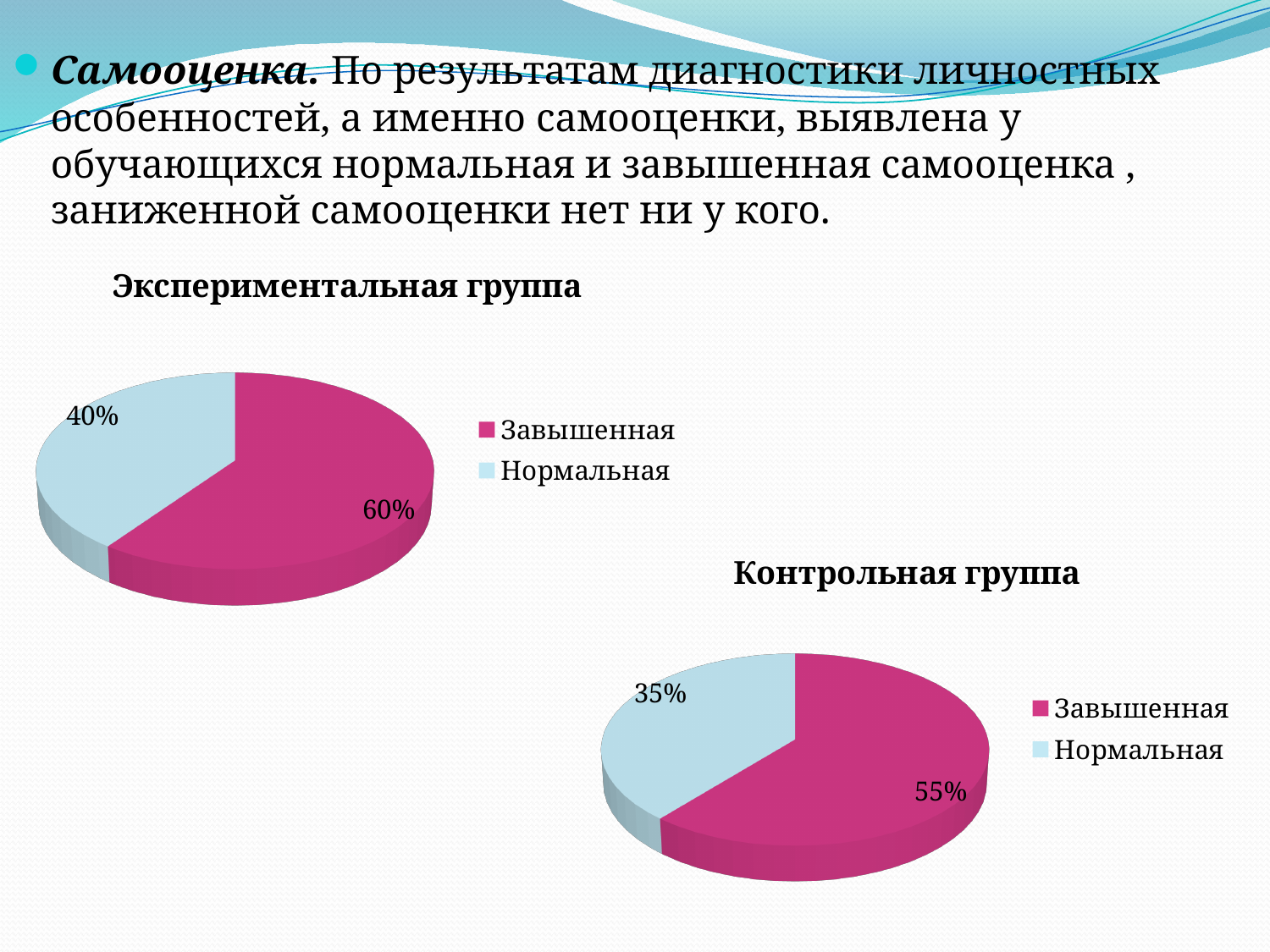
How many categories does the legend of the 'Экспериментальная группа' chart list? 2 In the 'Экспериментальная группа' chart, what is the difference between Завышенная and Нормальная? 20% In the 'Контрольная группа' chart, what is the difference between Завышенная and Нормальная? 20% Which is larger: Завышенная in the 'Экспериментальная группа' chart or Завышенная in the 'Контрольная группа' chart? Экспериментальная группа In the 'Экспериментальная группа' chart, what is the value for Завышенная? 60% In the 'Контрольная группа' chart, what is the value for Нормальная? 35% In the 'Экспериментальная группа' chart, what is the value for Нормальная? 40% What type of chart is the 'Контрольная группа' chart? Pie chart In the 'Контрольная группа' chart, what is the value for Завышенная? 55% In the 'Контрольная группа' chart, what colour is the Завышенная slice? Magenta (pink) In the 'Экспериментальная группа' chart, which category has the largest slice? Завышенная In the 'Контрольная группа' chart, which category has the smallest slice? Нормальная